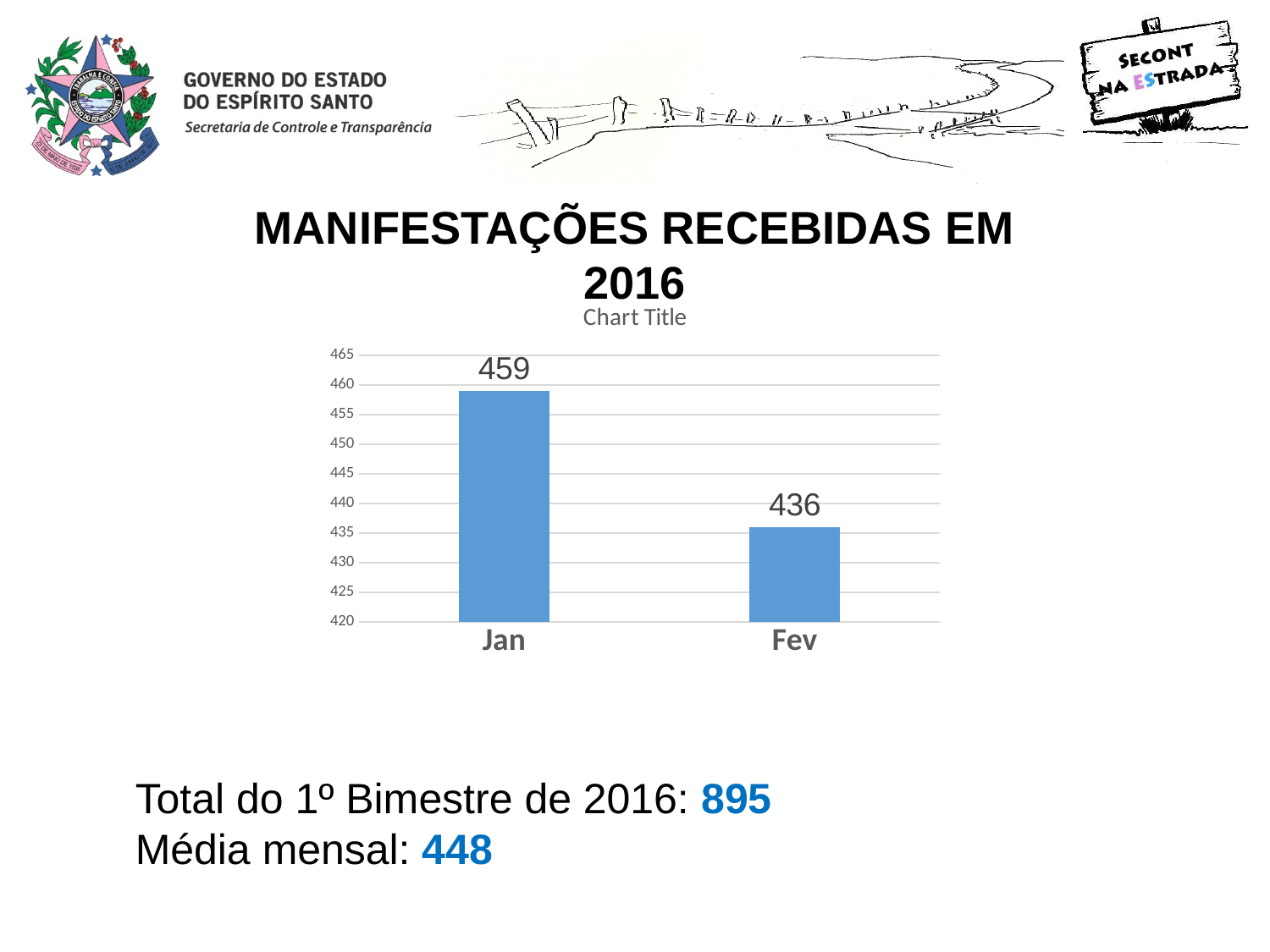
What is the value for Jan? 459 Which category has the lowest value? Fev Do the values rise or fall from Jan to Fev? fall Is the value for Jan greater or less than 450? greater Is the value for Fev greater or less than 440? less How many categories are shown on the x axis? 2 Which category has the highest value? Jan What kind of chart is shown on the slide? bar chart What is the value for Fev? 436 What is the title printed directly above the chart's plot area? Chart Title Which is larger, the value for Jan or the value for Fev? Jan What is the difference between the values for Jan and Fev? 23